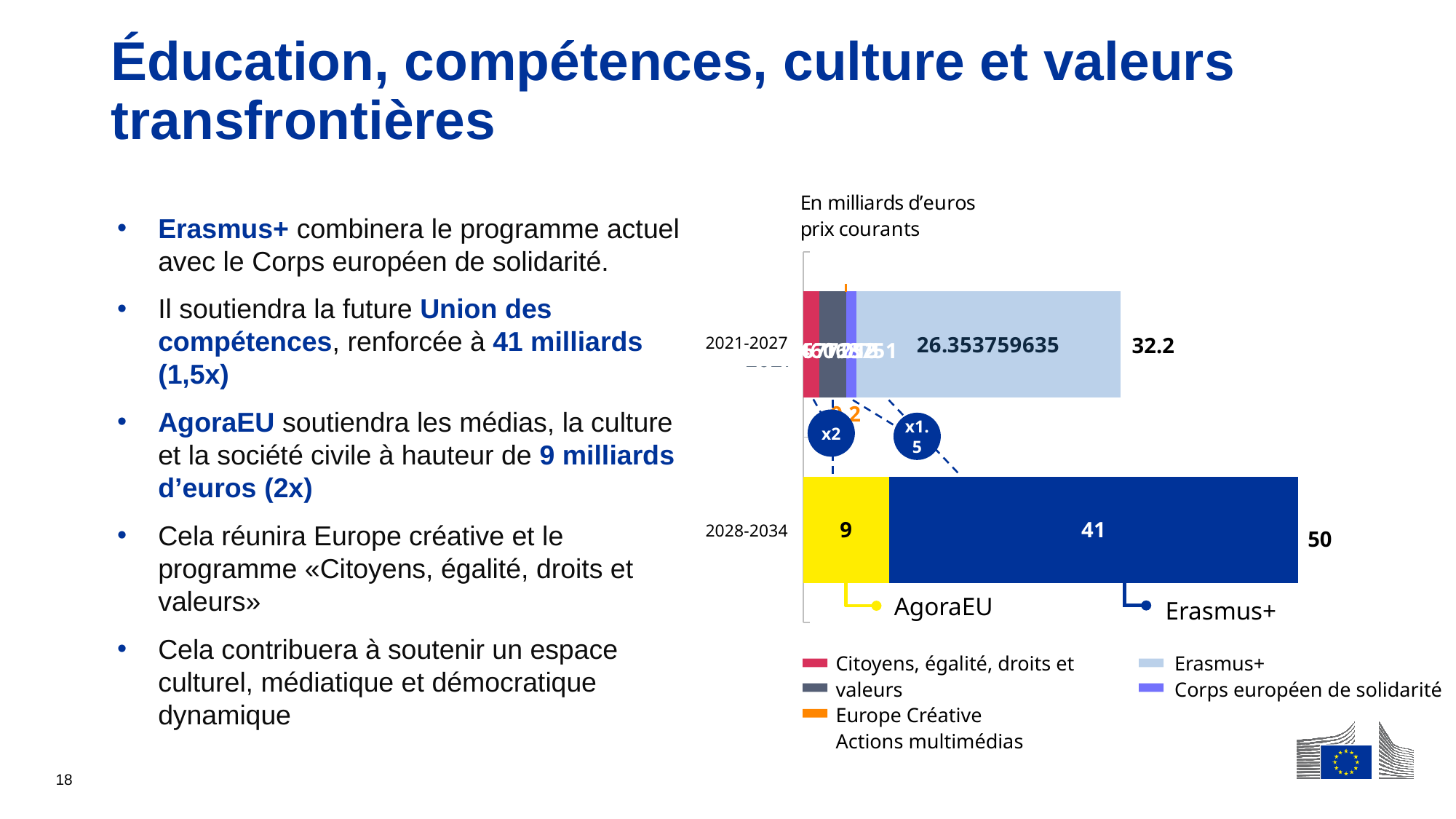
How many periods (categories) are plotted in the chart? 2 What kind of chart is shown on the slide? bar chart What unit is stated above the chart? En milliards d'euros prix courants What is the value of the Erasmus+ segment for 2021-2027? 26.353759635 What is the difference between the Erasmus+ and AgoraEU segments in the 2028-2034 bar? 32 What is the value of the AgoraEU segment for 2028-2034? 9 What is the difference between the totals of the 2028-2034 bar and the 2021-2027 bar? 17.8 What is the value of the Erasmus+ segment for 2028-2034? 41 Which period has the higher total value? 2028-2034 In the 2028-2034 bar, which segment is larger, AgoraEU or Erasmus+? Erasmus+ What is the total of the 2021-2027 bar? 32.2 What is the total of the 2028-2034 bar? 50